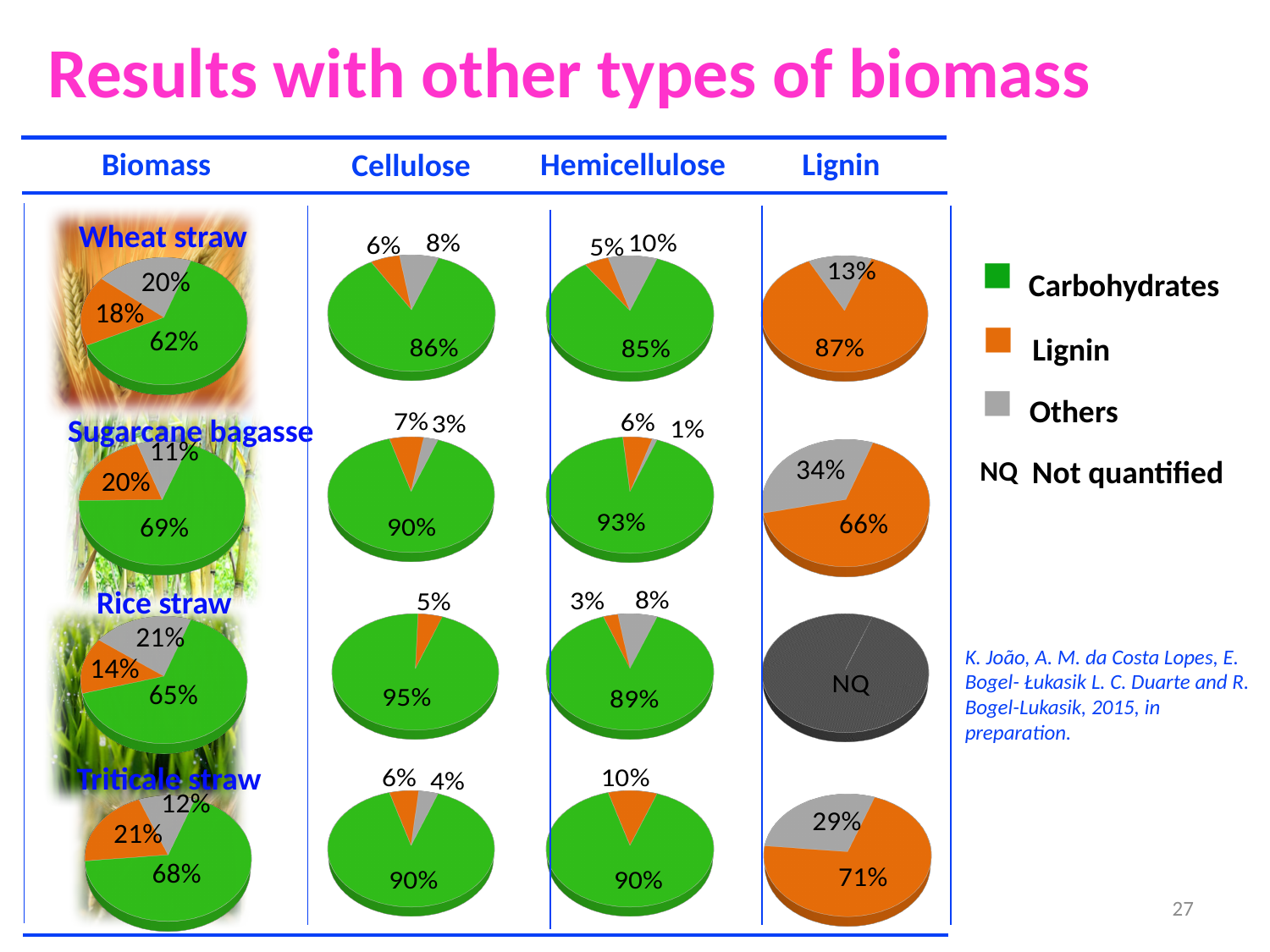
In the Wheat straw Lignin pie chart, what share is Lignin? 87% In the Wheat straw Biomass pie chart, which is larger, the Lignin slice or the Others slice? Others In the Rice straw Cellulose pie chart, what share is Carbohydrates? 95% In the Rice straw Biomass pie chart, which slice is the largest? Carbohydrates In the Sugarcane bagasse Lignin pie chart, what share is Others? 34% In the Triticale straw Biomass pie chart, what is the difference between the Carbohydrates share and the Lignin share? 47% In the Wheat straw Biomass pie chart, what share is Carbohydrates? 62% What type of chart is used throughout the table on this slide? Pie chart In the Triticale straw Hemicellulose pie chart, what share is Lignin? 10% How many entries does the colour legend on the right list? 3 In the Sugarcane bagasse Hemicellulose pie chart, which slice is the smallest? Others What is shown in the Rice straw Lignin chart instead of values? NQ (Not quantified)